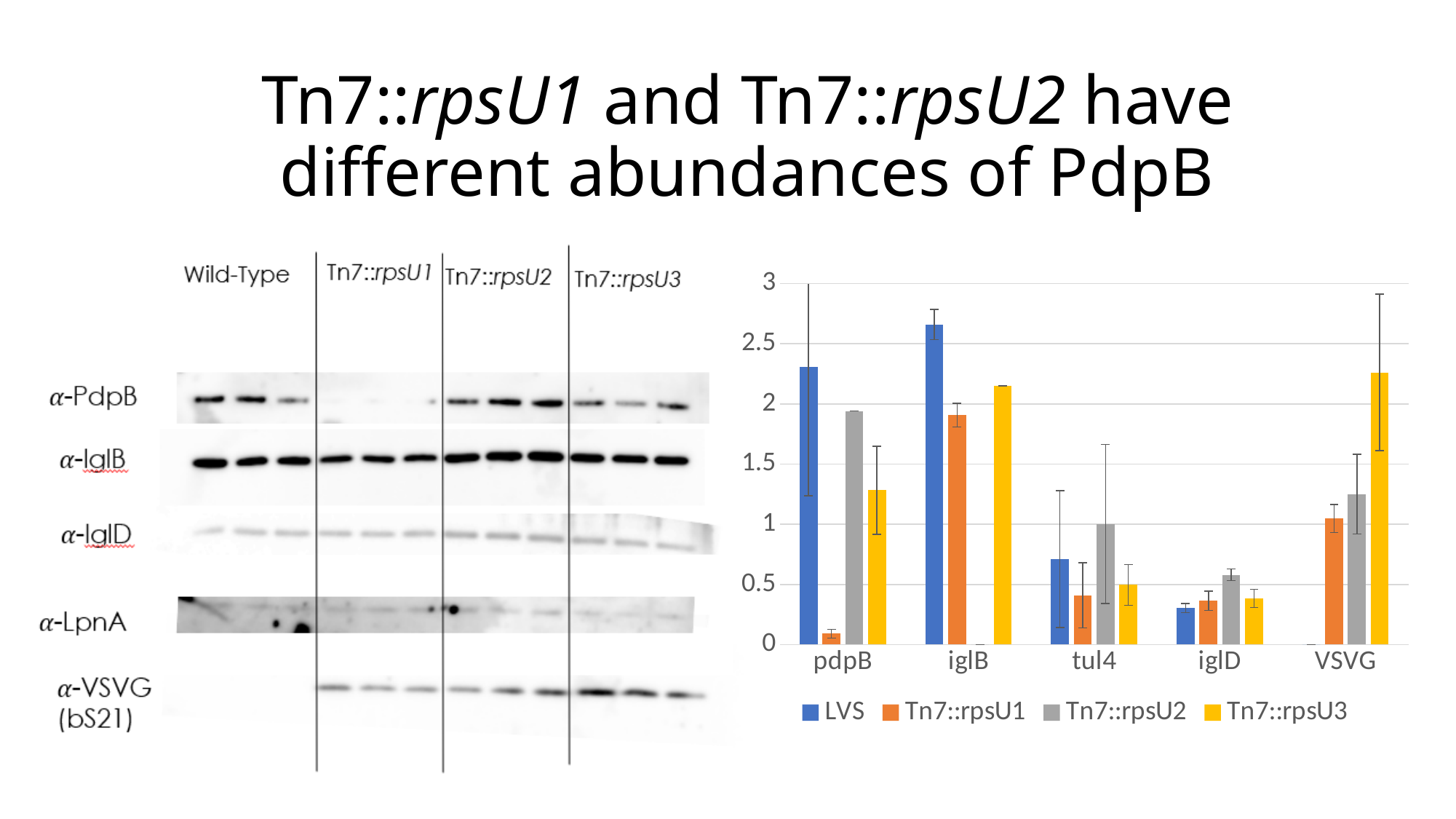
In the bar chart, which series has the highest value in the pdpB category? LVS In the bar chart, which is larger in the iglD category: the value for Tn7::rpsU2 or the value for LVS? Tn7::rpsU2 What kind of chart is shown on the right side of the slide? bar chart In the bar chart, is the value for Tn7::rpsU3 in the VSVG category greater or less than 2? greater In the bar chart, which series has the lowest value in the pdpB category? Tn7::rpsU1 In the bar chart, is the value for LVS in the iglB category greater or less than 2.5? greater In the bar chart, is the value for Tn7::rpsU1 in the pdpB category greater or less than 0.5? less How many series does the legend of the bar chart list? 4 In the bar chart, which series has the highest value in the VSVG category? Tn7::rpsU3 Which series in the bar chart is shown in orange? Tn7::rpsU1 How many categories are shown on the x axis of the bar chart? 5